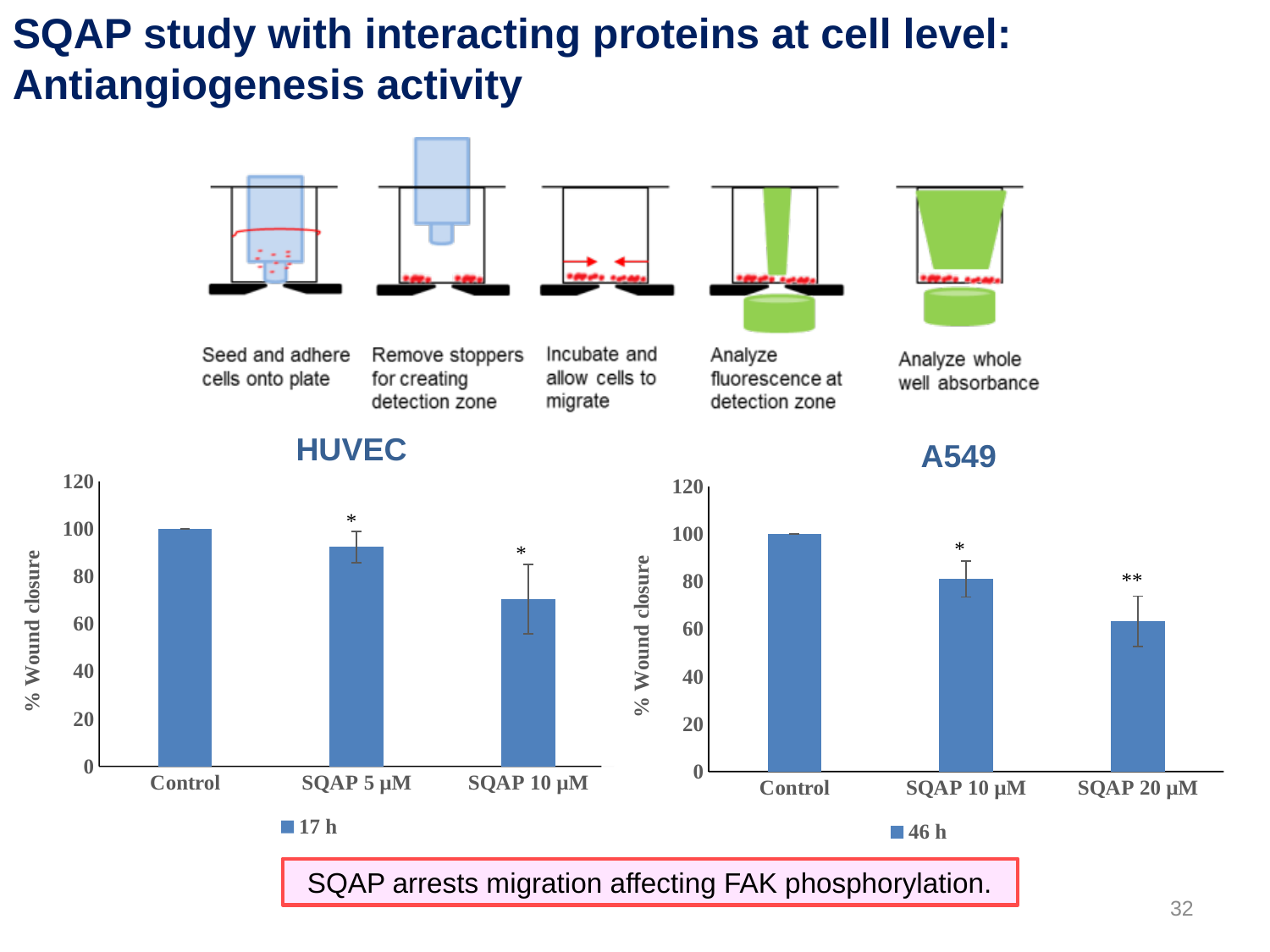
In the A549 chart, is the value for SQAP 10 µM greater or less than 60? greater In the A549 chart, do the values rise or fall from Control to SQAP 20 µM? fall In the A549 chart, how many categories are plotted on the x axis? 3 In the HUVEC chart, which category has the lowest % wound closure? SQAP 10 µM In the A549 chart, which category has the lowest % wound closure? SQAP 20 µM In the HUVEC chart, how many series does the legend list? 1 In the HUVEC chart, is the value for SQAP 10 µM greater or less than 80? less In the HUVEC chart, what kind of chart is shown? bar chart In the A549 chart, what is the legend entry? 46 h In the HUVEC chart, which category has the highest % wound closure? Control In the HUVEC chart, how many categories are plotted on the x axis? 3 In the HUVEC chart, what is the legend entry? 17 h